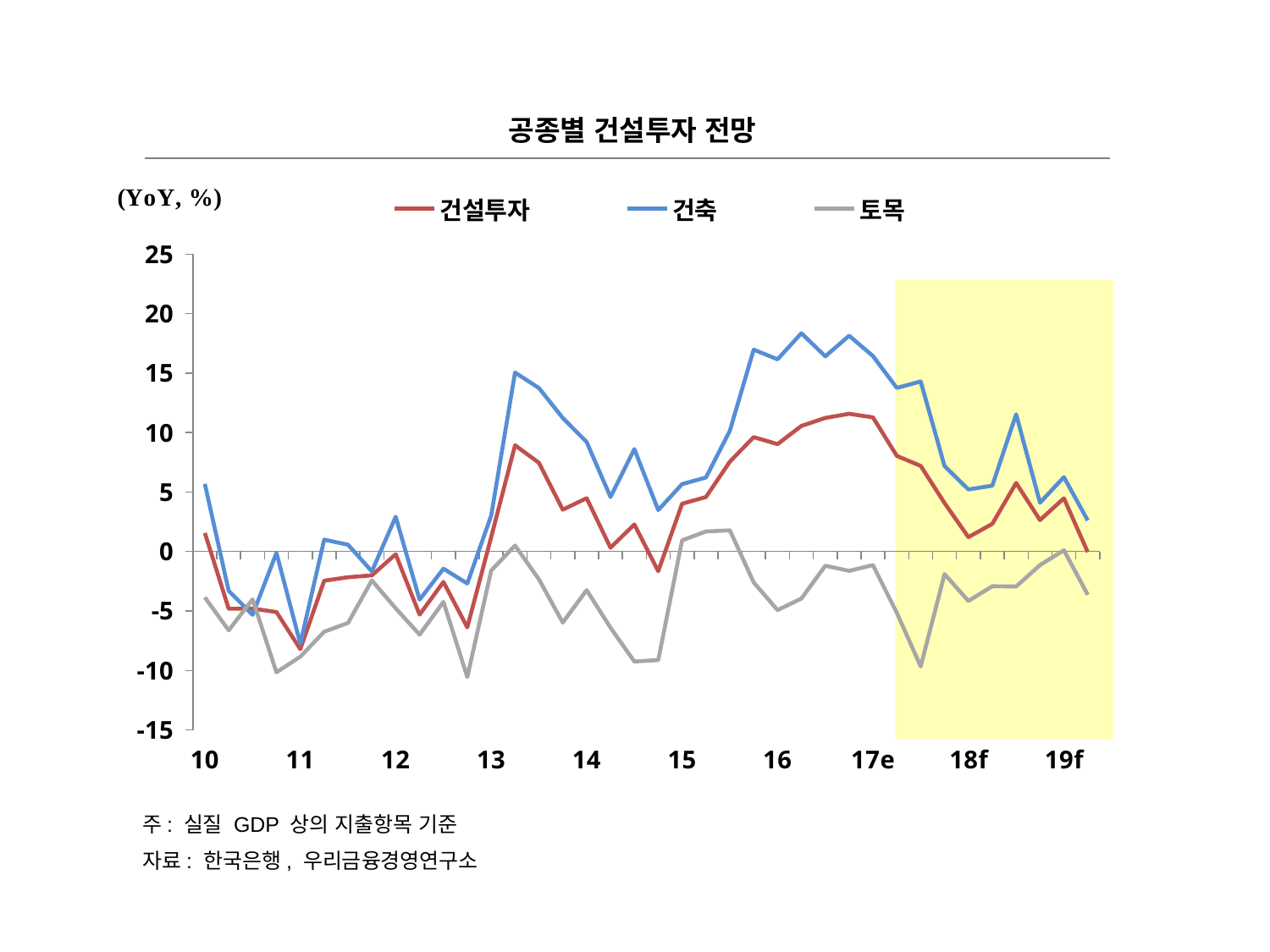
Is the value for 건설투자 at 17e greater or less than 10? greater At 16, which is larger: 건축 or 토목? 건축 Which series is drawn in blue? 건축 Which series has the lowest value at 18f? 토목 Which series has the highest value at 18f? 건축 Is the value for 토목 at 11 greater or less than -5? less Does the 건축 line rise or fall from 17e to 19f? fall Is the value for 토목 at 13 greater or less than 0? less What kind of chart is shown on the slide? line chart How many series does the legend list? 3 What is the title of the chart? 공종별 건설투자 전망